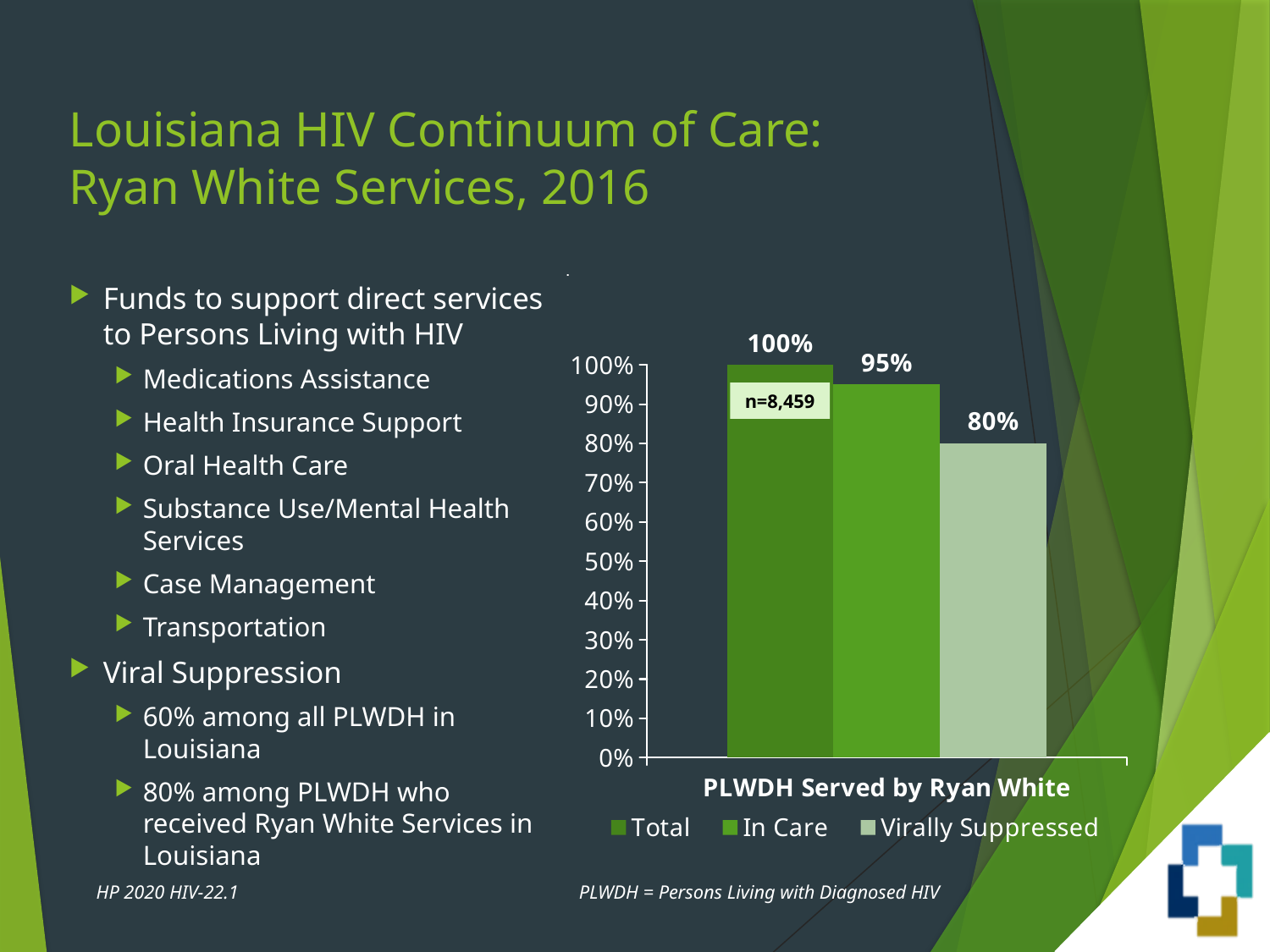
What is the value for In Care in the chart? 95% Which series has the highest value in the chart? Total Which is larger, the In Care value or the Virally Suppressed value? In Care What is the value for Total in the chart? 100% What is the x-axis category label of the chart? PLWDH Served by Ryan White What is the value for Virally Suppressed in the chart? 80% What kind of chart is shown on the slide? Bar chart What sample size (n) is printed on the Total bar? n=8,459 How many series does the legend list? 3 What is the difference between the In Care value and the Virally Suppressed value? 15% What is the difference between the Total value and the Virally Suppressed value? 20% Which series has the lowest value in the chart? Virally Suppressed